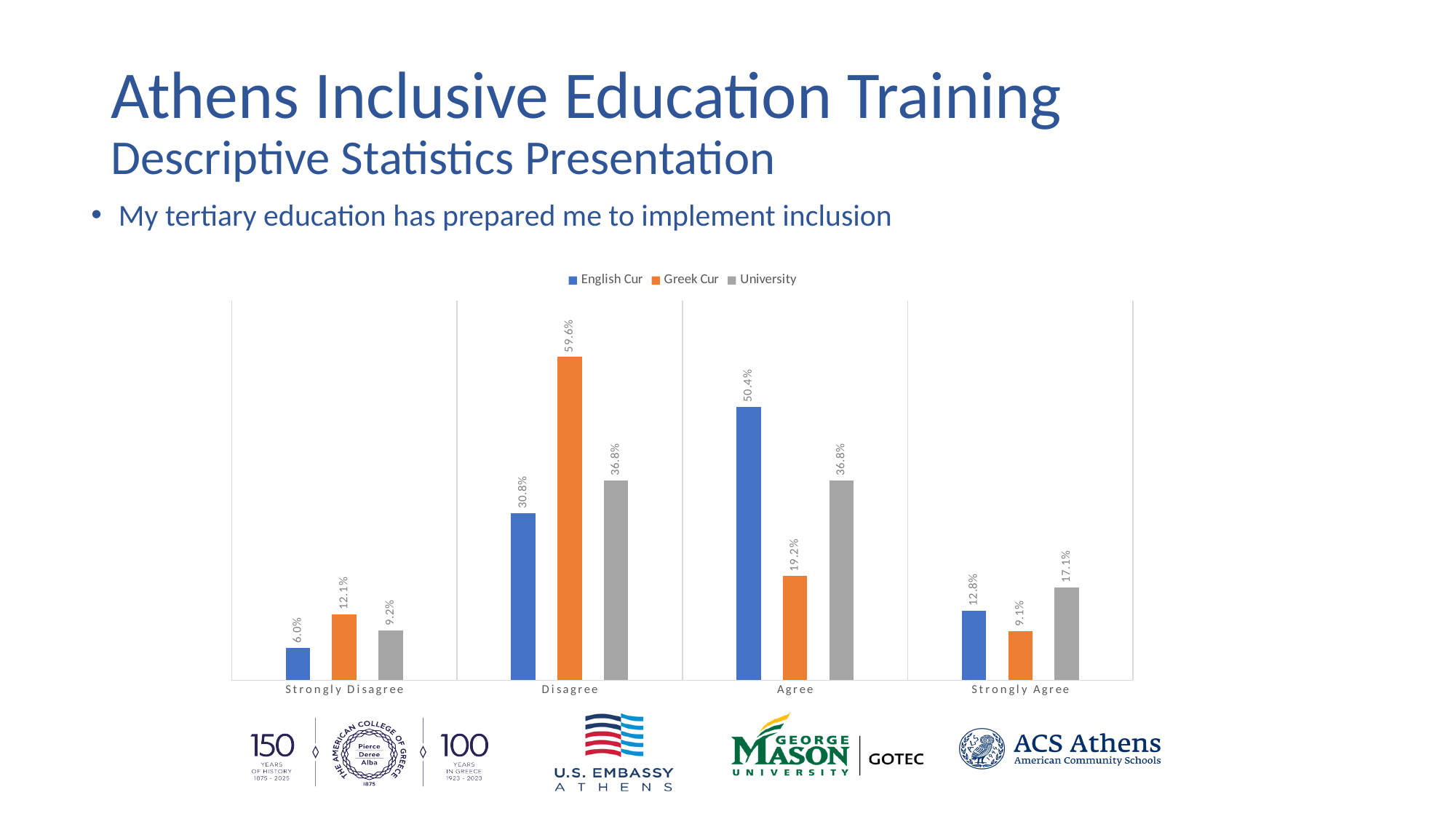
How many series does the legend list? 3 What is the difference between the Greek Cur and English Cur values in the Disagree category? 28.8% What is the value for Greek Cur in the Disagree category? 59.6% What is the value for English Cur in the Agree category? 50.4% What is the value for English Cur in the Strongly Disagree category? 6.0% Which category has the lowest value for University? Strongly Disagree How many categories are shown on the x axis? 4 In the Agree category, which is larger: English Cur or University? English Cur What is the value for University in the Strongly Agree category? 17.1% Which category has the highest value for Greek Cur? Disagree What colour represents the University series? Grey What kind of chart is shown on the slide? Bar chart